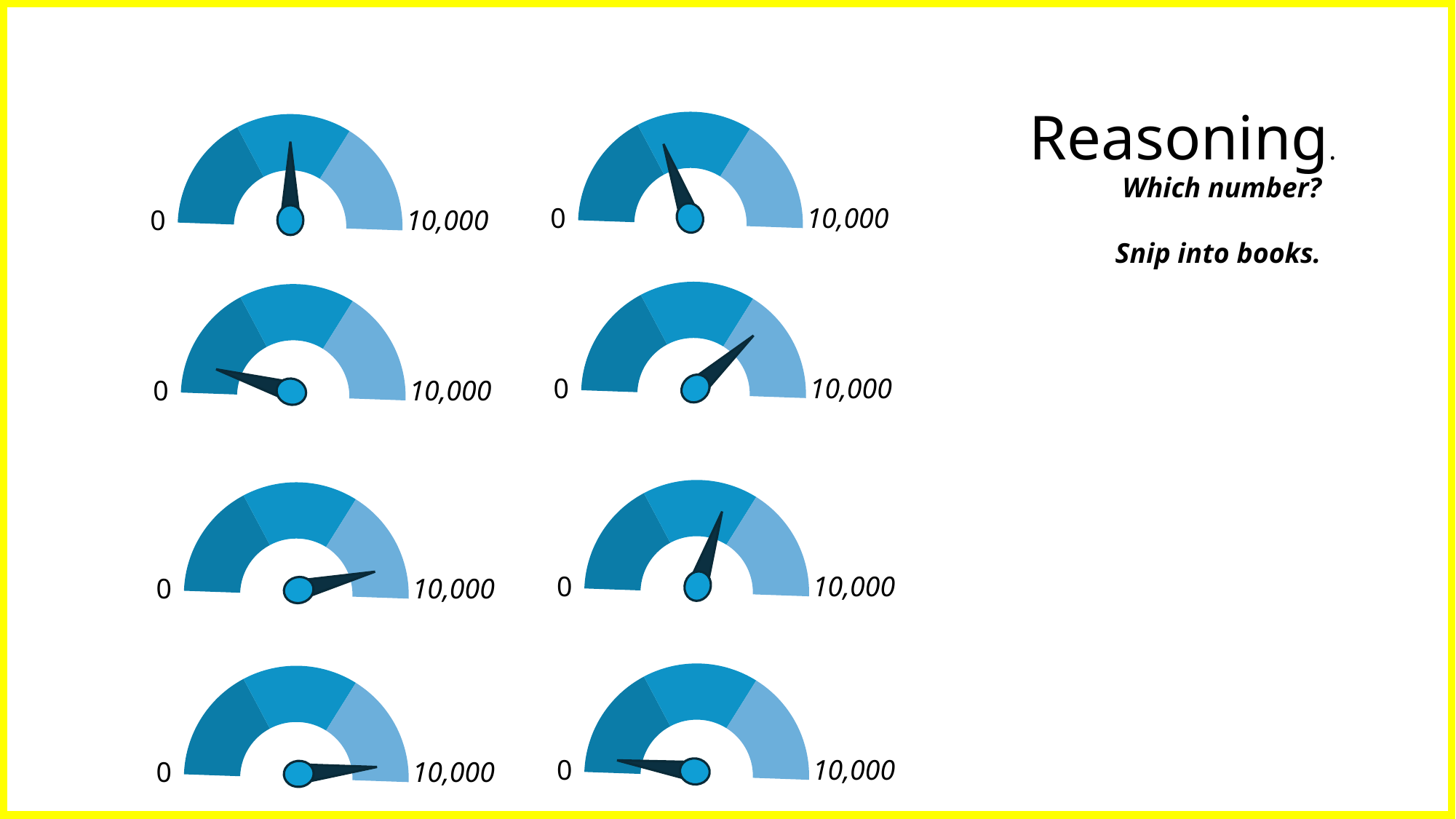
What is the minimum value labelled on each gauge? 0 On the gauge in the second row, left column, is the needle closer to 0 or to 10,000? 0 How many gauge charts are on the slide? 8 What kind of charts are shown on the slide? Gauge charts On the gauge in the fourth row, right column, is the needle closer to 0 or to 10,000? 0 Which gauge shows the larger value: the one in the fourth row, left column, or the one in the fourth row, right column? Fourth row, left column On the gauge in the third row, left column, is the needle closer to 0 or to 10,000? 10,000 What is the maximum value labelled on each gauge? 10,000 Which gauge shows the larger value: the one in the first row, left column, or the one in the first row, right column? First row, left column Which gauge shows the larger value: the one in the first row, right column, or the one in the third row, left column? Third row, left column